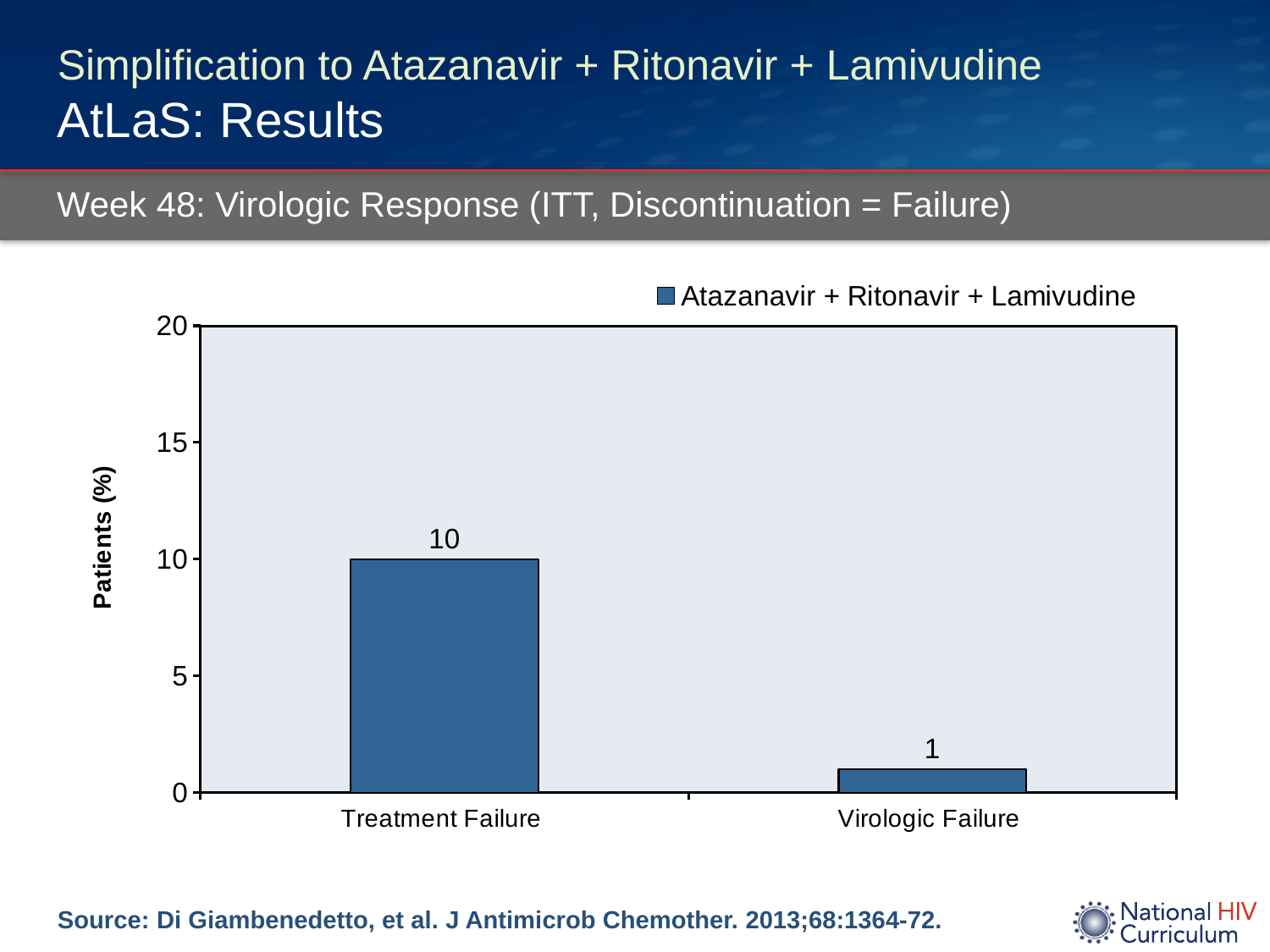
Which category has the highest value? Treatment Failure What kind of chart is shown on the slide? bar chart What is the value for Treatment Failure? 10 Which category has the lowest value? Virologic Failure What series name is shown in the legend? Atazanavir + Ritonavir + Lamivudine Which is larger, the value for Treatment Failure or the value for Virologic Failure? Treatment Failure How many series does the legend list? 1 What is the value for Virologic Failure? 1 Is the value for Treatment Failure greater or less than 5? greater What is the label of the y axis? Patients (%) How many categories are shown on the x axis? 2 What is the difference between the values for Treatment Failure and Virologic Failure? 9